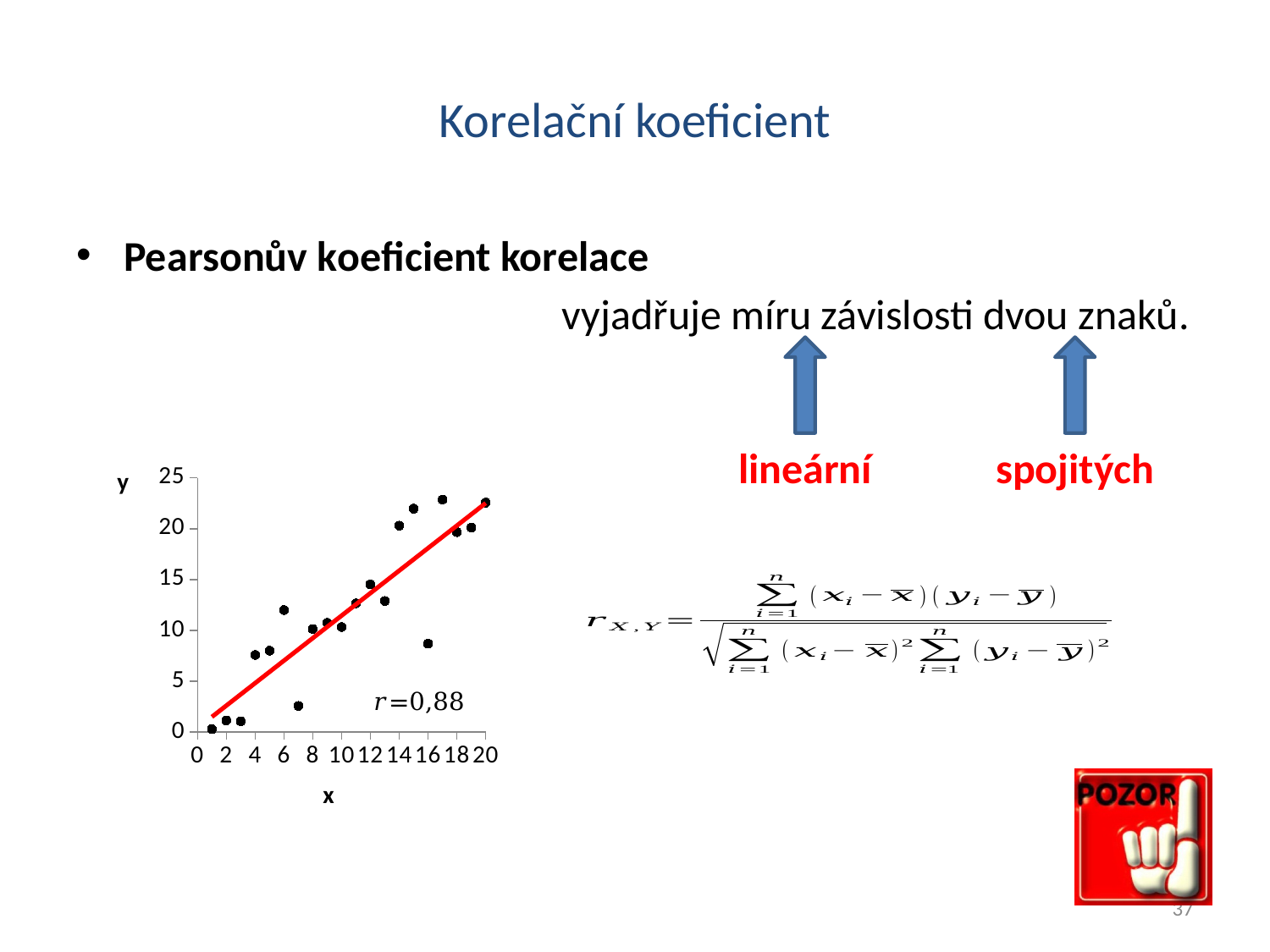
Which point has the larger y value, the one at x = 14 or the one at x = 16? x = 14 Is the y value of the point at x = 7 greater or less than 5? less Is the y value of the point at x = 16 greater or less than 10? less Is the y value of the point at x = 6 greater or less than 10? greater Do the y values generally rise or fall as x increases along the x axis? rise What value of the correlation coefficient r is printed on the chart? r=0,88 Which point has the larger y value, the one at x = 6 or the one at x = 7? x = 6 What kind of chart is shown on the slide? scatter chart What is the highest tick value shown on the y axis of the chart? 25 What colour is the trend line drawn through the points on the chart? red